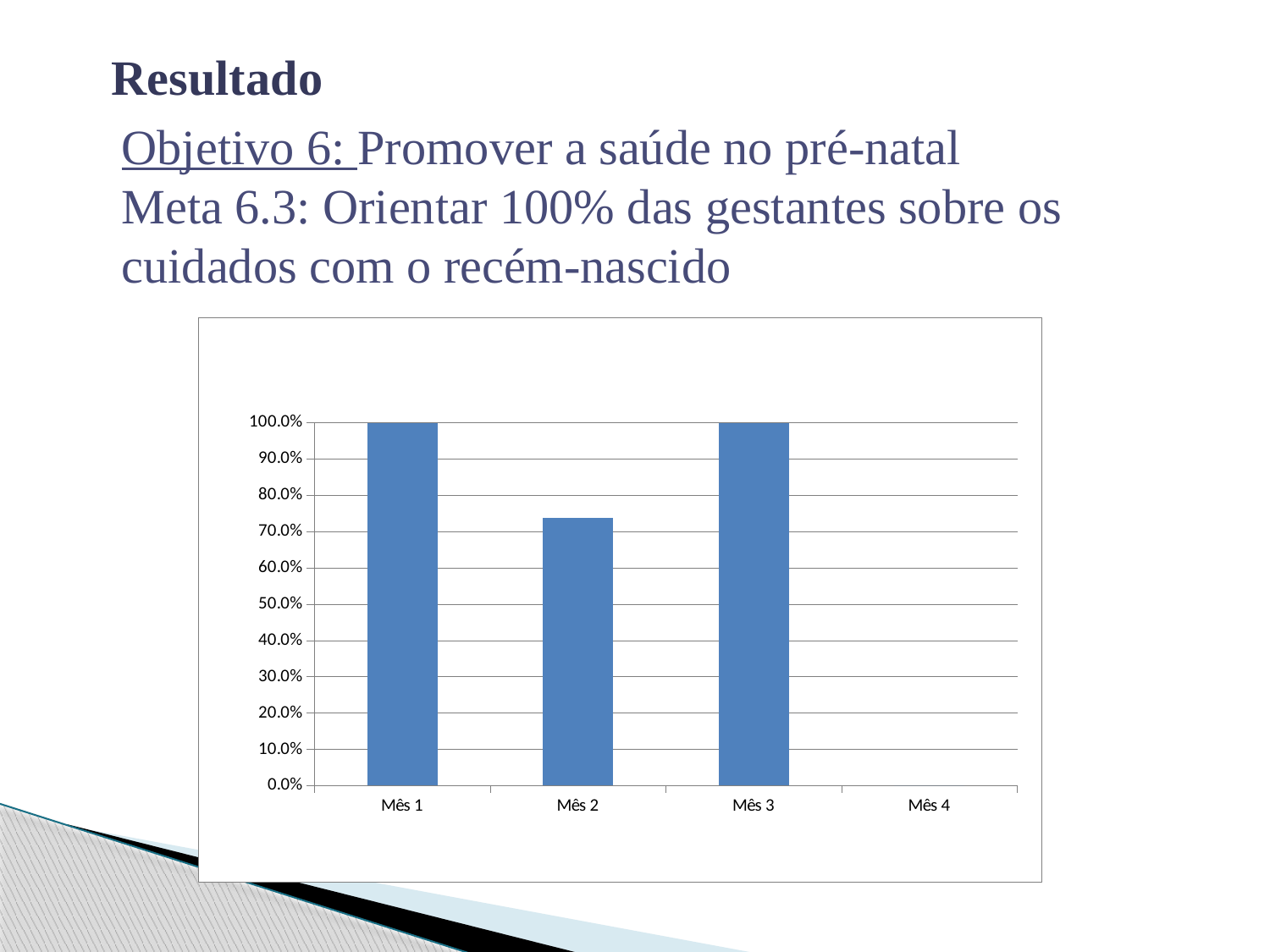
What kind of chart is shown on the slide? bar chart Which is larger, the value for Mês 1 or the value for Mês 2? Mês 1 What is the value for Mês 4? 0.0% What is the highest tick value shown on the y axis? 100.0% Which month has the lowest value? Mês 4 What is the value for Mês 3? 100.0% Which is larger, the value for Mês 2 or the value for Mês 3? Mês 3 How many months are shown on the x axis? 4 What is the value for Mês 1? 100.0% Is the value for Mês 2 greater or less than 70.0%? greater What is the difference between the value for Mês 1 and the value for Mês 4? 100.0% Is the value for Mês 2 greater or less than 80.0%? less